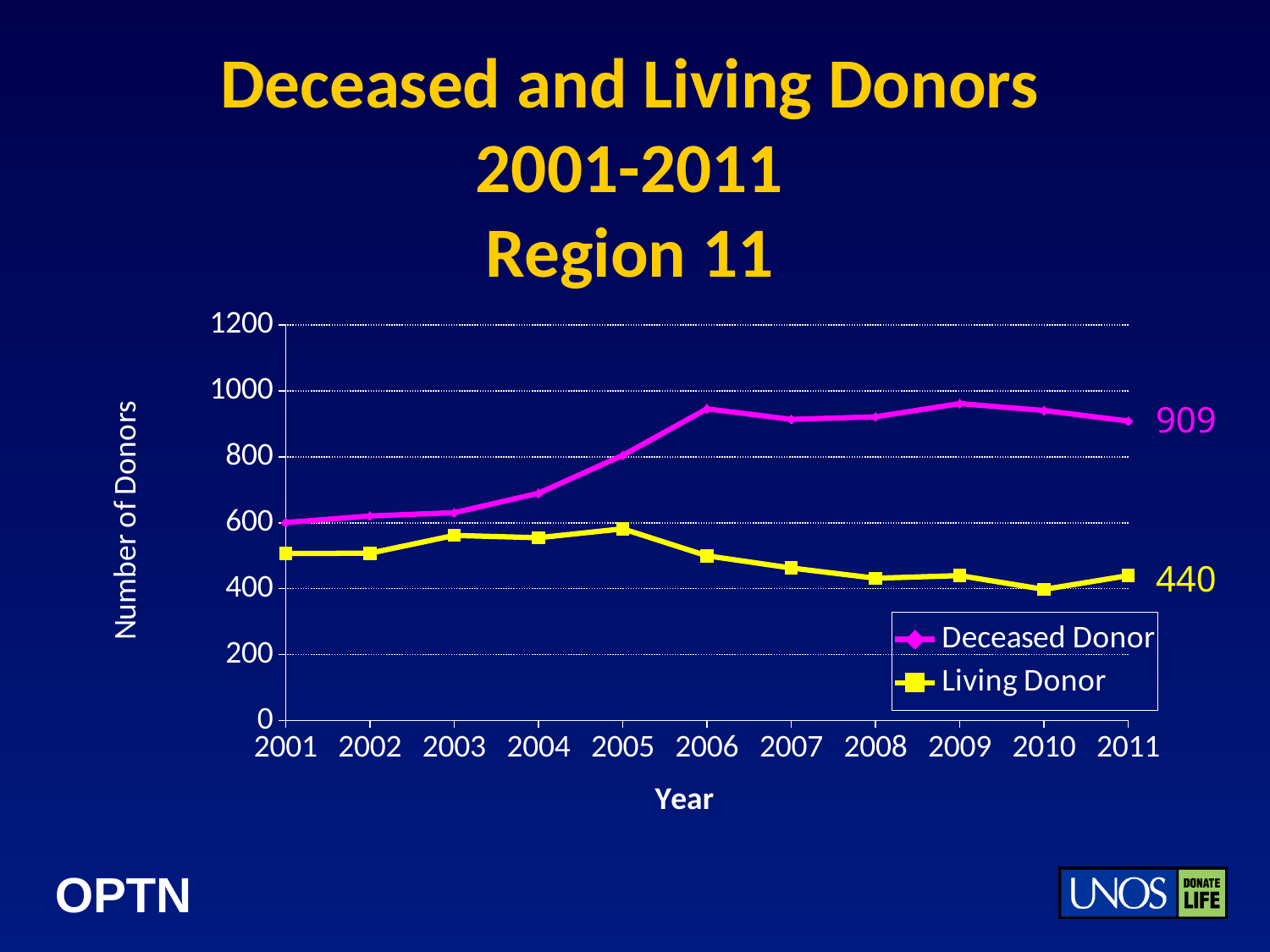
Is the value for Living Donor in 2010 greater or less than 600? less How many years are shown on the x axis? 11 What is the difference between the Deceased Donor and Living Donor values in 2011? 469 In which year is the Living Donor value lowest? 2010 What is the value for Living Donor in 2011? 440 What is the value for Deceased Donor in 2011? 909 Is the value for Deceased Donor in 2001 greater or less than 800? less What kind of chart is shown on the slide? line chart How many series does the legend list? 2 Does the Deceased Donor series generally rise or fall from 2001 to 2006? rise Is the value for Deceased Donor in 2009 greater or less than 800? greater Which series has the larger value in 2011, Deceased Donor or Living Donor? Deceased Donor